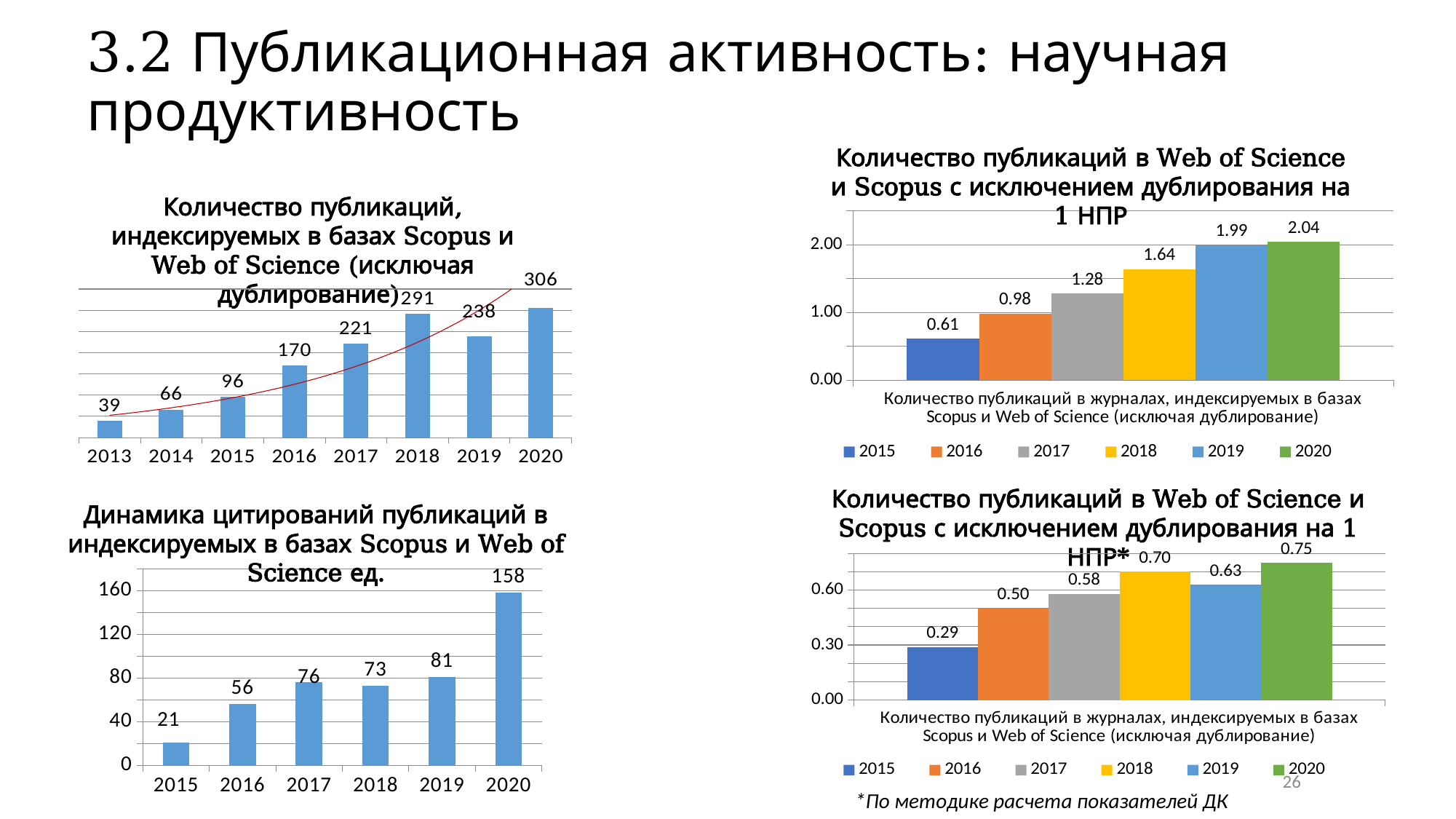
In the bottom-left chart (Динамика цитирований публикаций), what is the value for 2020? 158 In the top-left chart (Количество публикаций, индексируемых в базах Scopus и Web of Science), what is the value for 2018? 291 In the bottom-left chart (Динамика цитирований публикаций), is the value for 2017 larger or smaller than the value for 2018? larger In the top-left chart (Количество публикаций, индексируемых в базах Scopus и Web of Science), which year has the highest value? 2020 In the top-left chart (Количество публикаций, индексируемых в базах Scopus и Web of Science), what is the difference between the values for 2020 and 2019? 68 In the bottom-right chart (Количество публикаций в Web of Science и Scopus с исключением дублирования на 1 НПР*), what is the value for 2019? 0.63 In the top-right chart (Количество публикаций в Web of Science и Scopus с исключением дублирования на 1 НПР), do the values rise or fall from 2015 to 2020? rise How many entries does the legend of the bottom-right chart (на 1 НПР*) list? 6 In the top-right chart (Количество публикаций в Web of Science и Scopus с исключением дублирования на 1 НПР), what is the value for 2017? 1.28 What type of chart is the bottom-left chart (Динамика цитирований публикаций)? bar chart In the bottom-left chart (Динамика цитирований публикаций), which year has the lowest value? 2015 How many years are shown on the x axis of the top-left chart (Количество публикаций, индексируемых в базах Scopus и Web of Science)? 8